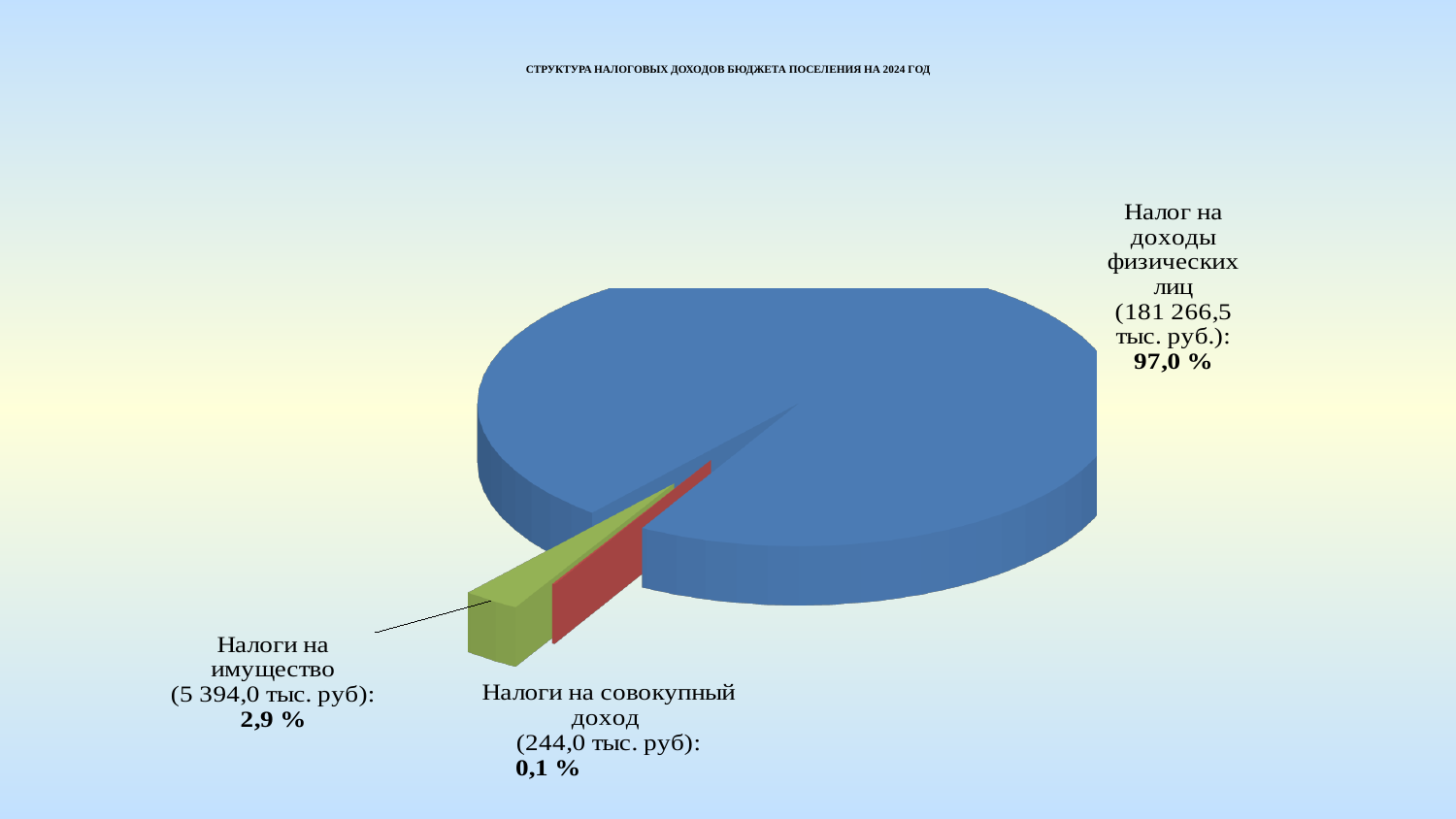
What kind of chart is shown on the slide? Pie chart What is the value in тыс. руб. for "Налог на доходы физических лиц"? 181 266,5 тыс. руб. What share of the pie does "Налог на доходы физических лиц" represent? 97,0 % What share of the pie does "Налоги на совокупный доход" represent? 0,1 % How many slices does the pie chart have? 3 What is the title of the chart? СТРУКТУРА НАЛОГОВЫХ ДОХОДОВ БЮДЖЕТА ПОСЕЛЕНИЯ НА 2024 ГОД What share of the pie does "Налоги на имущество" represent? 2,9 % What is the value in тыс. руб. for "Налоги на имущество"? 5 394,0 тыс. руб. What is the difference in percentage points between the shares of "Налоги на имущество" and "Налоги на совокупный доход"? 2,8 % Which category has the largest slice of the pie? Налог на доходы физических лиц Which category has the smallest slice of the pie? Налоги на совокупный доход What is the value in тыс. руб. for "Налоги на совокупный доход"? 244,0 тыс. руб.